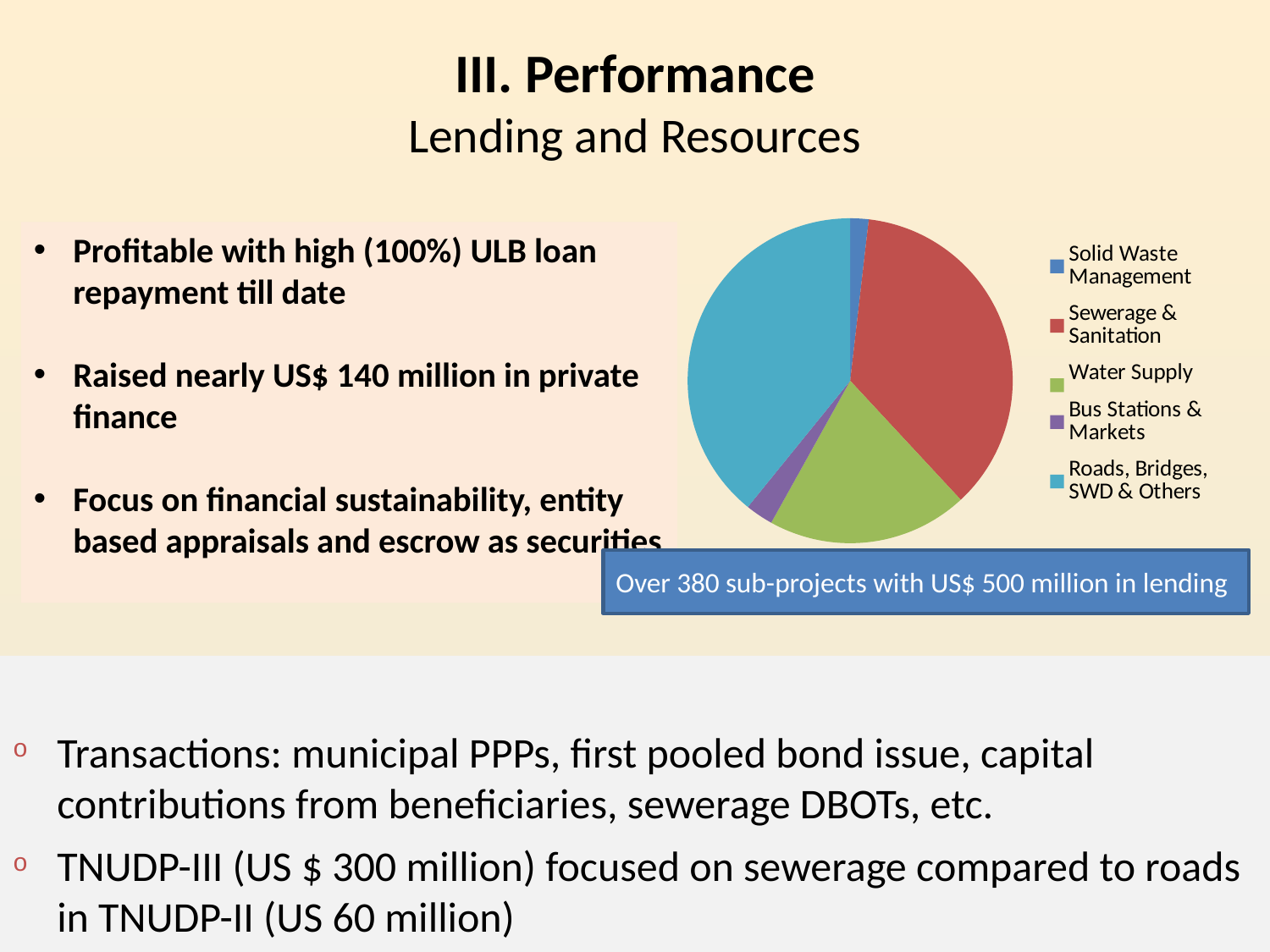
Which slice is larger in the pie chart: Sewerage & Sanitation or Water Supply? Sewerage & Sanitation What does the caption box below the pie chart say? Over 380 sub-projects with US$ 500 million in lending How many entries does the legend of the pie chart list? 5 Which slice is larger in the pie chart: Water Supply or Bus Stations & Markets? Water Supply Which slice is larger in the pie chart: Sewerage & Sanitation or Solid Waste Management? Sewerage & Sanitation What kind of chart is shown on the slide? pie chart Which category has the smallest slice in the pie chart? Solid Waste Management How many categories does the pie chart show? 5 What colour is the Sewerage & Sanitation slice in the pie chart? red